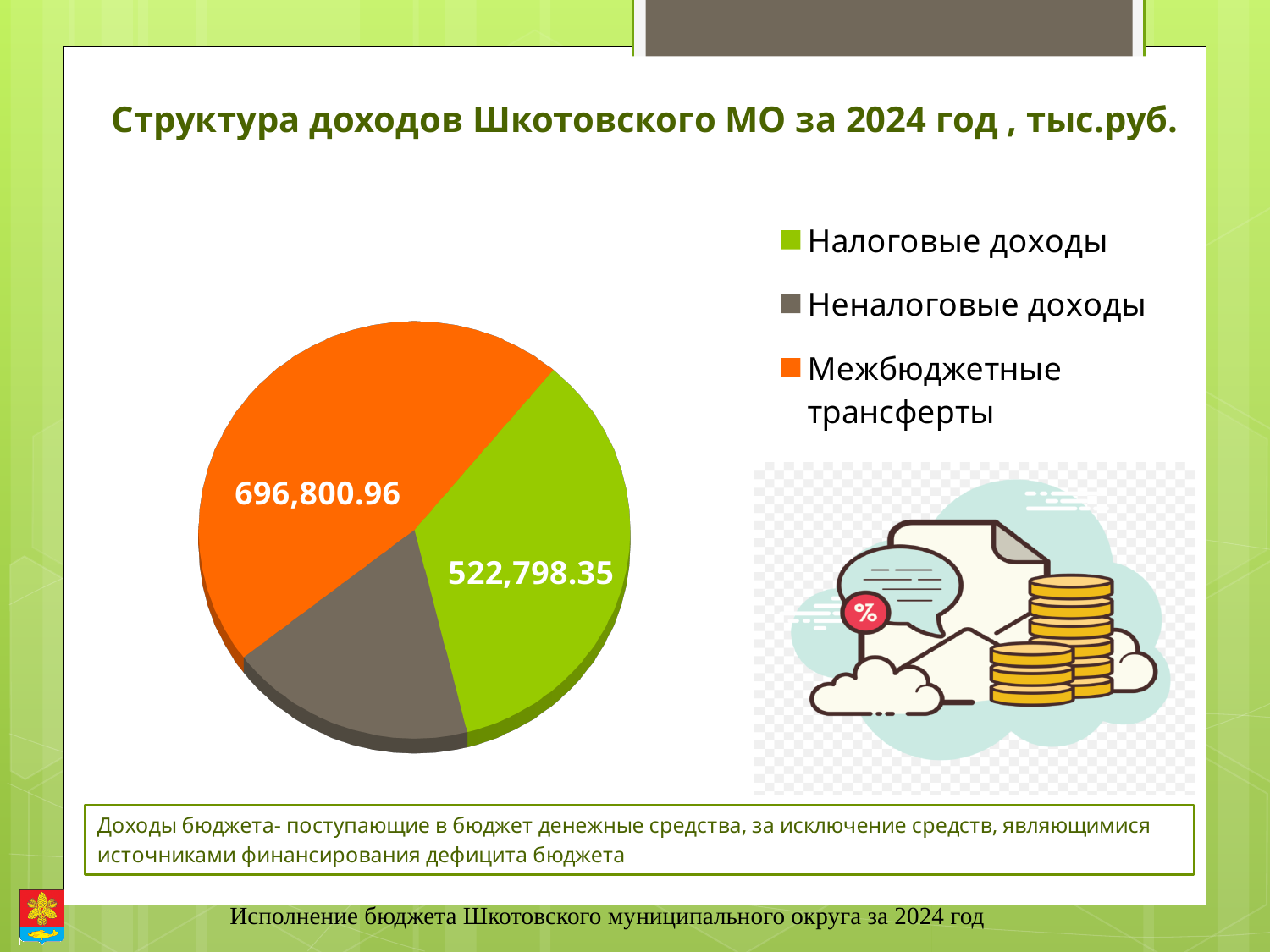
What is the value for Межбюджетные трансферты? 696,800.96 What is the title of the chart? Структура доходов Шкотовского МО за 2024 год , тыс.руб. What is the value for Налоговые доходы? 522,798.35 How many categories are shown in the pie chart? 3 What kind of chart is shown on the slide? Pie chart Which category has the smallest slice of the pie? Неналоговые доходы Which category has the largest slice of the pie? Межбюджетные трансферты Which is larger, Неналоговые доходы or Налоговые доходы? Налоговые доходы Which is larger, Налоговые доходы or Межбюджетные трансферты? Межбюджетные трансферты What is the difference between the values for Межбюджетные трансферты and Налоговые доходы? 174,002.61 How many entries does the legend list? 3 What colour represents Неналоговые доходы in the chart? Grey